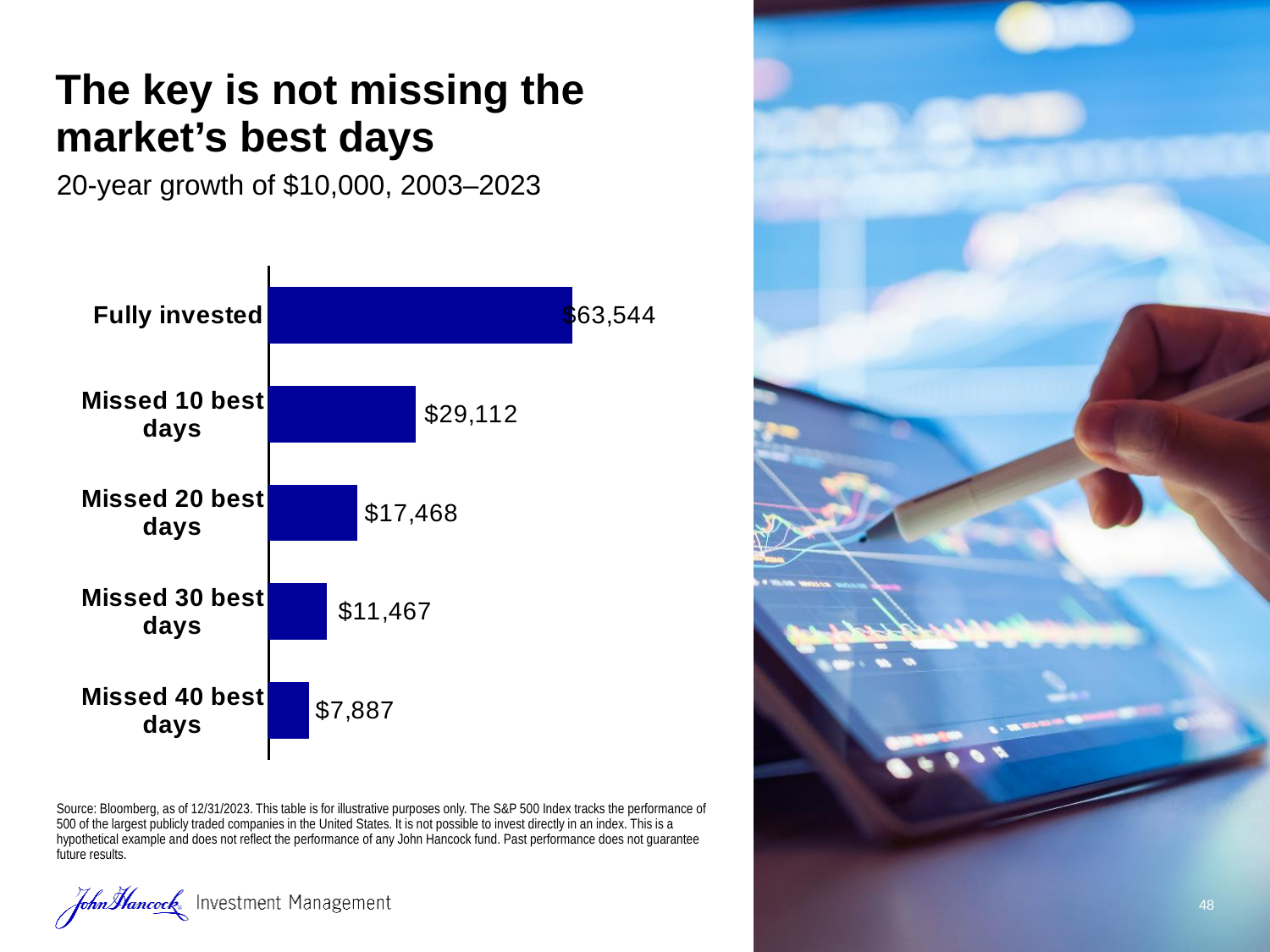
What is the value for Missed 10 best days? $29,112 What is the value for Missed 20 best days? $17,468 What is the value for Missed 30 best days? $11,467 What is the value for Missed 40 best days? $7,887 What is the subtitle describing the chart's data? 20-year growth of $10,000, 2003–2023 Which is larger, the value for Missed 20 best days or the value for Missed 30 best days? Missed 20 best days What is the difference between the Fully invested value and the Missed 10 best days value? $34,432 Which category has the lowest value? Missed 40 best days What is the value for Fully invested? $63,544 How many categories are shown in the chart? 5 Which category has the highest value? Fully invested What kind of chart is shown on the slide? Bar chart